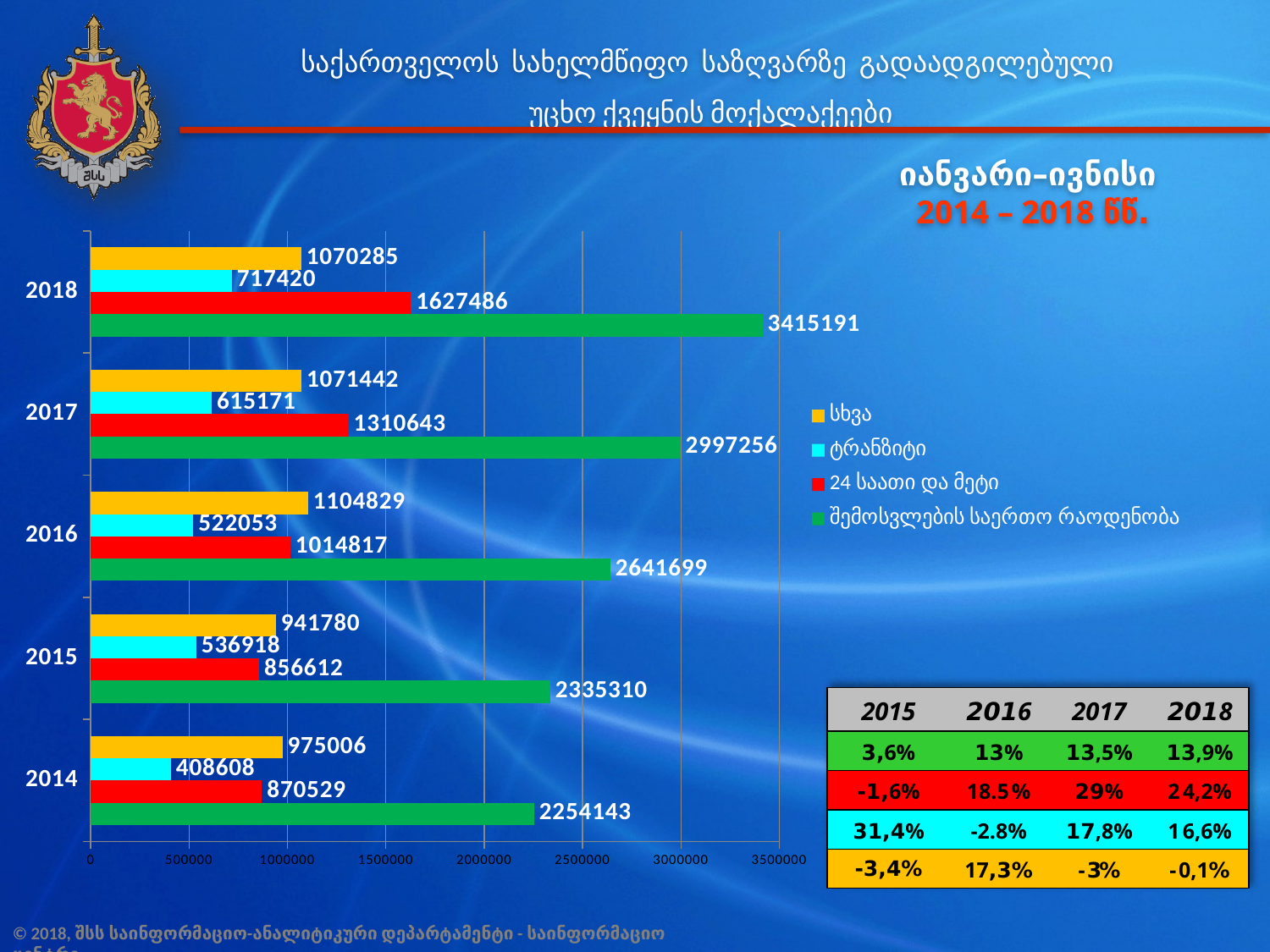
What is the value of the cyan series (ტრანზიტი) for 2014? 408608 What is the difference between the red series (24 საათი და მეტი) values for 2018 and 2017? 316843 What is the value of the green series (შემოსვლების საერთო რაოდენობა) for 2018? 3415191 Which year has the highest value for the green series (შემოსვლების საერთო რაოდენობა)? 2018 What is the value of the yellow series (სხვა) for 2015? 941780 How many years are shown on the chart? 5 Which year has the lowest value for the cyan series (ტრანზიტი)? 2014 Is the green series (შემოსვლების საერთო რაოდენობა) value for 2017 greater or less than 3000000? less How many series does the legend list? 4 Which is larger: the yellow series (სხვა) value for 2016 or for 2017? 2016 What kind of chart is shown on the slide? bar chart What is the value of the red series (24 საათი და მეტი) for 2016? 1014817